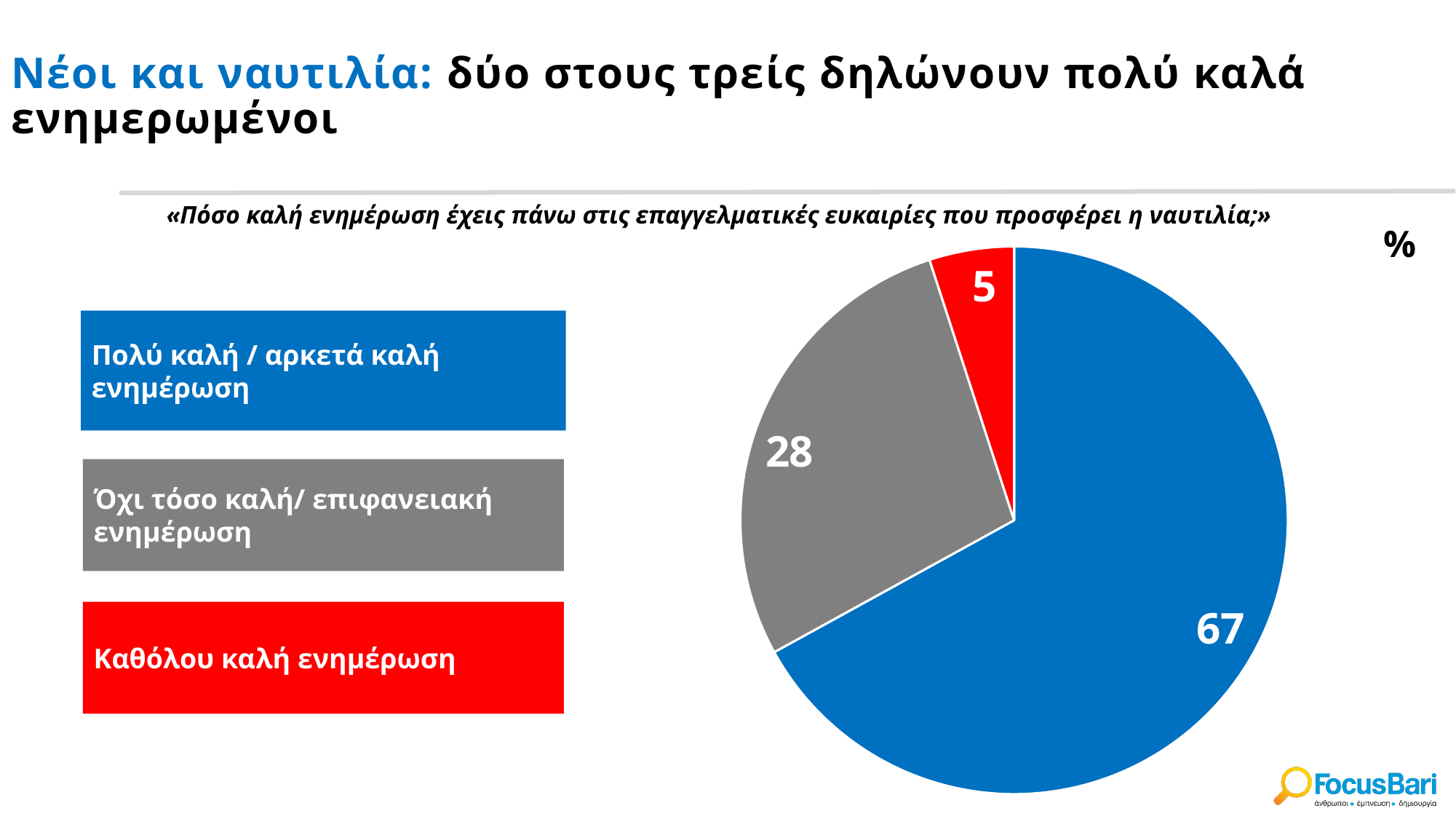
How many slices does the pie chart have? 3 What is the value for "Όχι τόσο καλή/ επιφανειακή ενημέρωση"? 28 What colour is the slice for "Όχι τόσο καλή/ επιφανειακή ενημέρωση"? grey What share of the pie does the "Καθόλου καλή ενημέρωση" slice represent? 5% What type of chart is shown on the slide? pie chart What unit is indicated next to the pie chart? % Which category has the largest slice of the pie? Πολύ καλή / αρκετά καλή ενημέρωση What is the value for "Καθόλου καλή ενημέρωση"? 5 Which category has the smallest slice of the pie? Καθόλου καλή ενημέρωση What is the value for "Πολύ καλή / αρκετά καλή ενημέρωση"? 67 Which is larger: the value for "Όχι τόσο καλή/ επιφανειακή ενημέρωση" or the value for "Καθόλου καλή ενημέρωση"? Όχι τόσο καλή/ επιφανειακή ενημέρωση What is the difference between the values for "Πολύ καλή / αρκετά καλή ενημέρωση" and "Όχι τόσο καλή/ επιφανειακή ενημέρωση"? 39